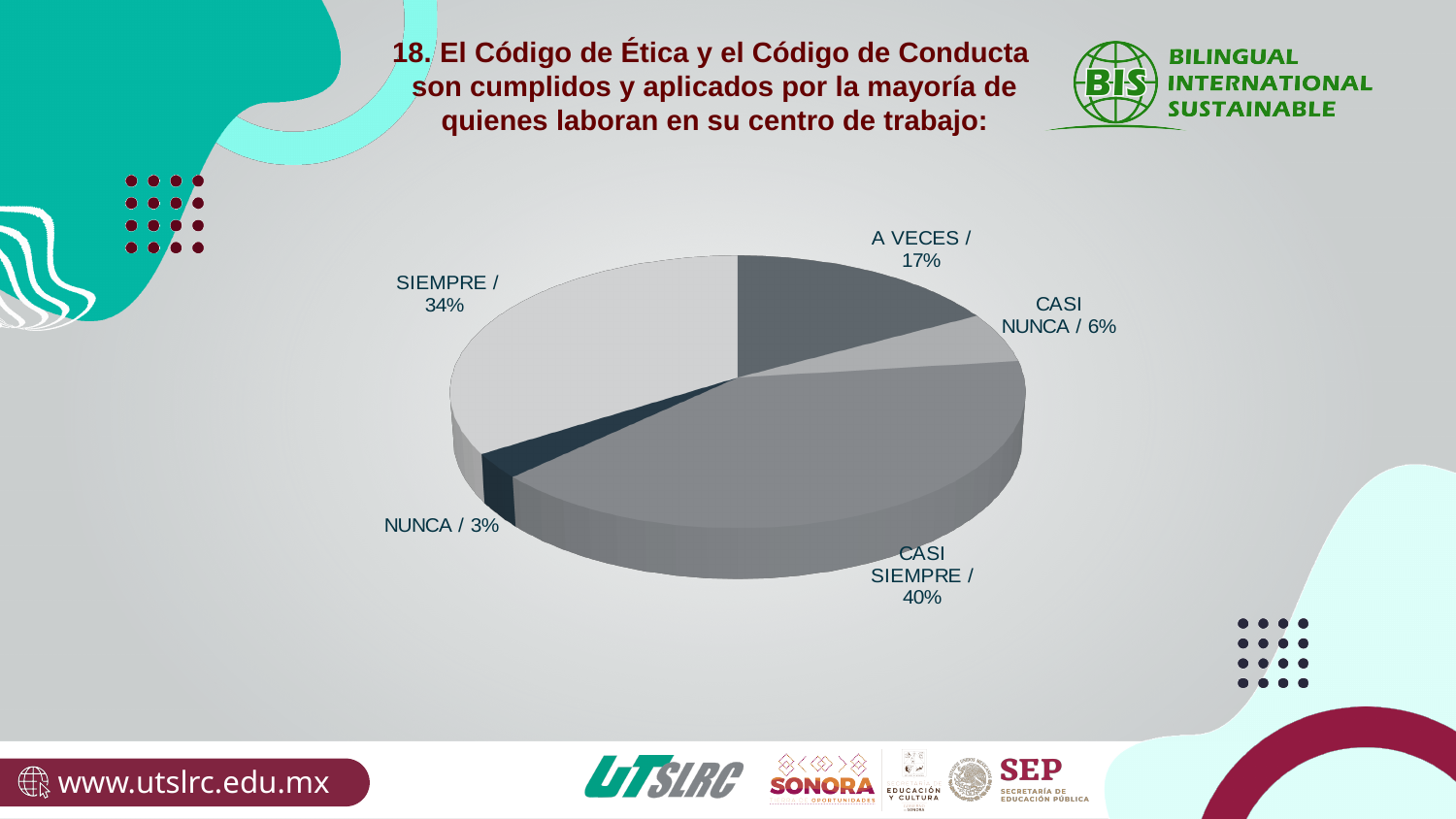
What percentage is shown for A VECES? 17% What is the combined percentage of SIEMPRE and CASI SIEMPRE? 74% What percentage is shown for CASI SIEMPRE? 40% What percentage is shown for NUNCA? 3% How many slices does the pie chart have? 5 What percentage is shown for SIEMPRE? 34% Which category has the largest share of the pie? CASI SIEMPRE What percentage is shown for CASI NUNCA? 6% What kind of chart is shown on the slide? pie chart What is the difference in percentage points between CASI SIEMPRE and SIEMPRE? 6 Which is larger, the share for A VECES or the share for CASI NUNCA? A VECES Which category has the smallest share of the pie? NUNCA